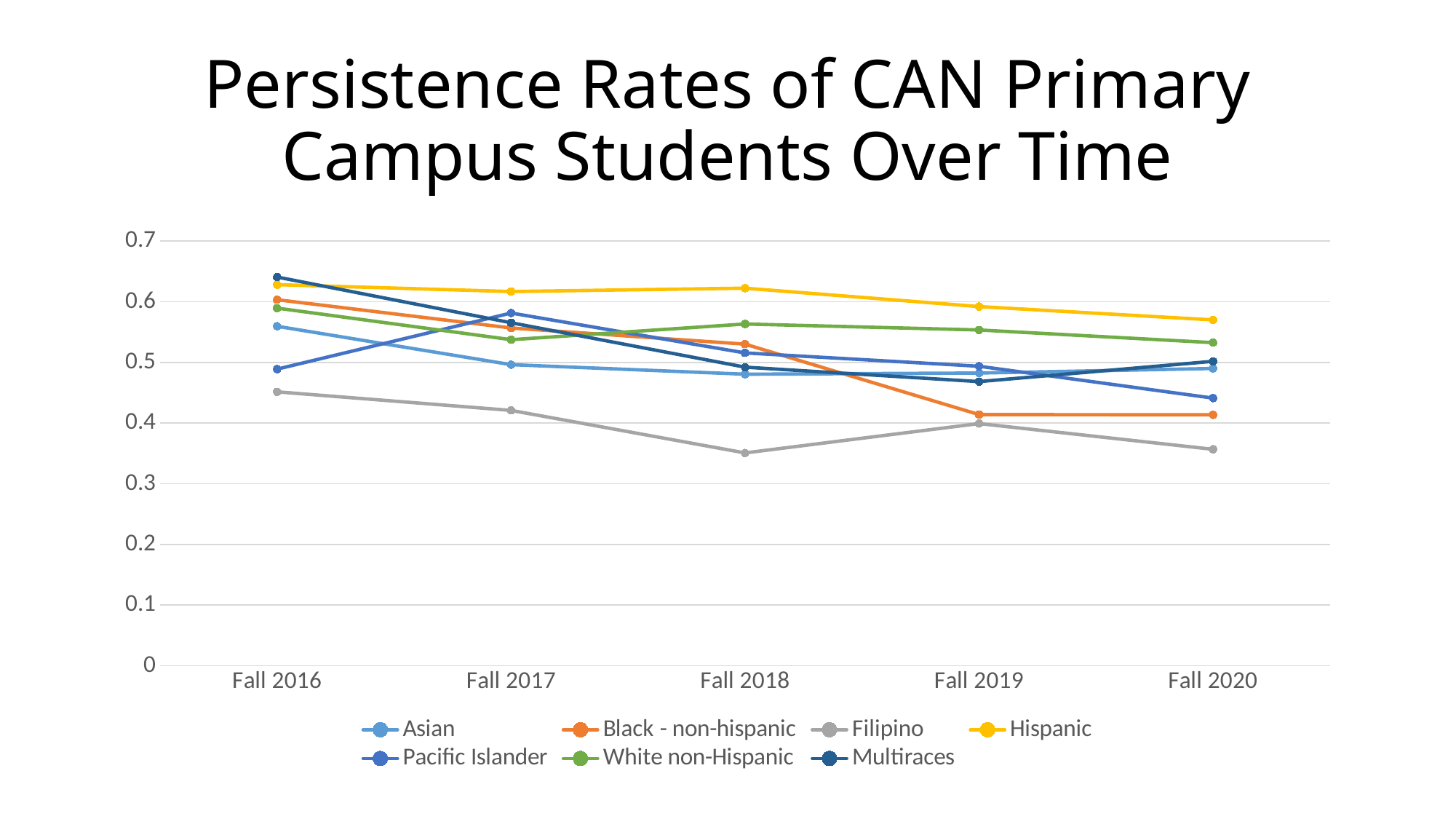
What kind of chart is shown on the slide? line chart How many time points are shown on the x axis? 5 Is the value for Hispanic in Fall 2016 greater or less than 0.6? greater Which group has the lowest persistence rate in Fall 2020? Filipino What colour is the Hispanic line in the legend? yellow Which group has the lowest persistence rate in Fall 2018? Filipino Does the Hispanic persistence rate rise or fall from Fall 2016 to Fall 2020? fall In Fall 2020, which is higher: White non-Hispanic or Black - non-hispanic? White non-Hispanic How many series does the legend list? 7 Is the value for Filipino in Fall 2018 greater or less than 0.4? less Is the value for Filipino in Fall 2016 greater or less than 0.5? less Which group has the highest persistence rate in Fall 2020? Hispanic